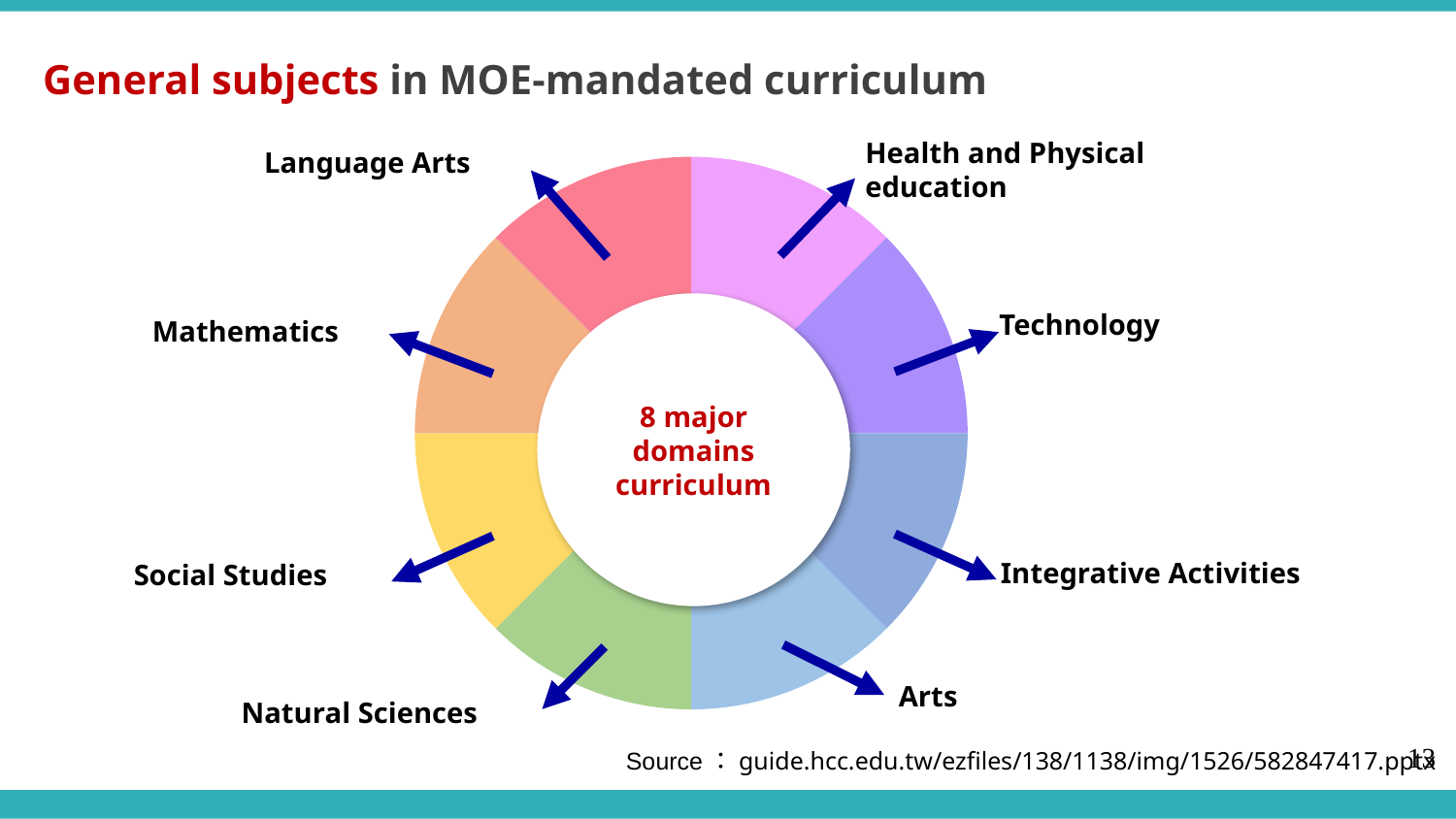
What kind of chart is shown on the slide? Doughnut chart Which segment of the doughnut chart is labelled at the top right, next to Technology? Health and Physical education What is the title of the slide containing the doughnut chart? General subjects in MOE-mandated curriculum Which domain is labelled between Language Arts and Social Studies on the left side of the chart? Mathematics What text appears in the centre of the doughnut chart? 8 major domains curriculum How many segments does the doughnut chart have? 8 Which domain is labelled between Social Studies and Arts at the bottom of the chart? Natural Sciences Do the eight segments of the doughnut chart appear to be equal in size? Yes Which domain is labelled between Technology and Arts on the right side of the chart? Integrative Activities